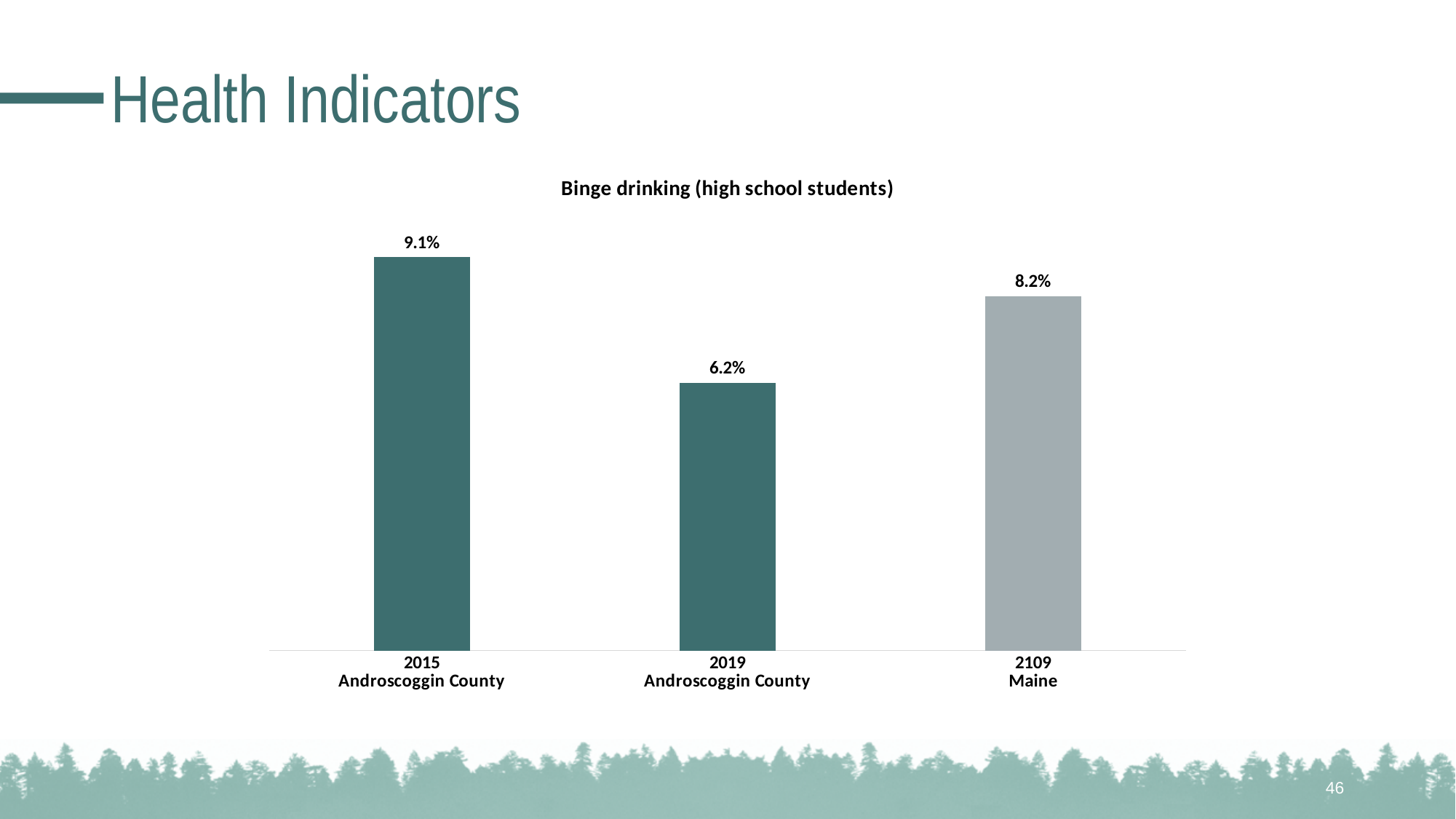
What kind of chart is shown on the slide? Bar chart What is the difference between the Maine value and the 2019 Androscoggin County value? 2.0% Did the Androscoggin County value rise or fall from 2015 to 2019? Fall What is the value for 2015 Androscoggin County? 9.1% What is the title of the chart? Binge drinking (high school students) Which category has the lowest value? 2019 Androscoggin County What is the value for the Maine bar (labelled 2109)? 8.2% How many bars are shown in the chart? 3 What is the value for 2019 Androscoggin County? 6.2% Which is larger, the 2019 Androscoggin County value or the Maine value? Maine What is the difference between the 2015 and 2019 Androscoggin County values? 2.9% Which category has the highest value? 2015 Androscoggin County